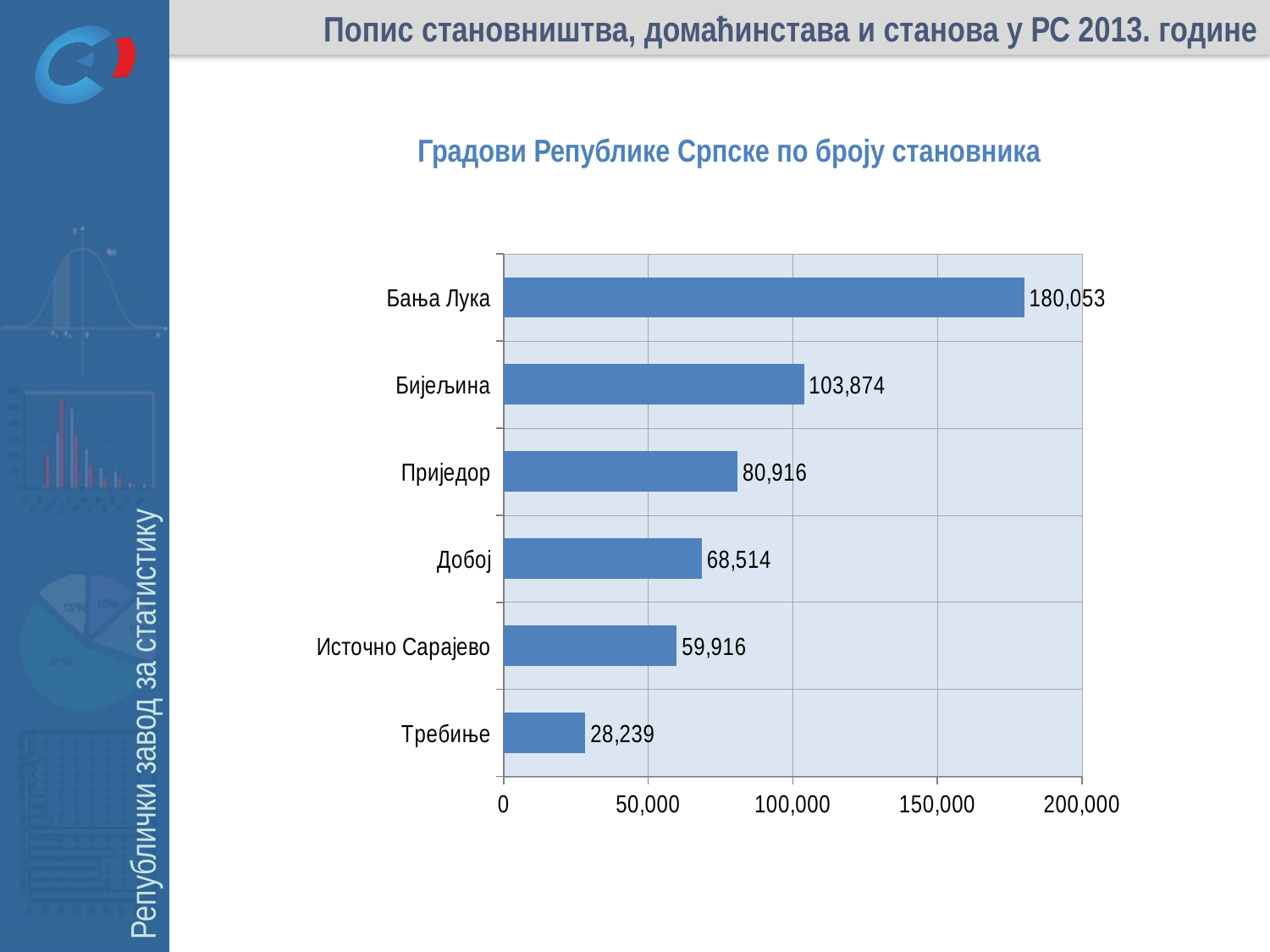
What is the population value shown for Приједор? 80,916 Is the value for Бијељина greater or less than 100,000? greater What is the difference between the populations of Бања Лука and Бијељина? 76,179 Which has a larger population, Приједор or Добој? Приједор How many cities are shown in the chart? 6 What is the title of the chart? Градови Републике Српске по броју становника What is the population value shown for Бања Лука? 180,053 What is the population value shown for Требиње? 28,239 What type of chart is shown on the slide? bar chart Which city has the highest population in the chart? Бања Лука What is the difference between the populations of Добој and Источно Сарајево? 8,598 Which city has the lowest population in the chart? Требиње